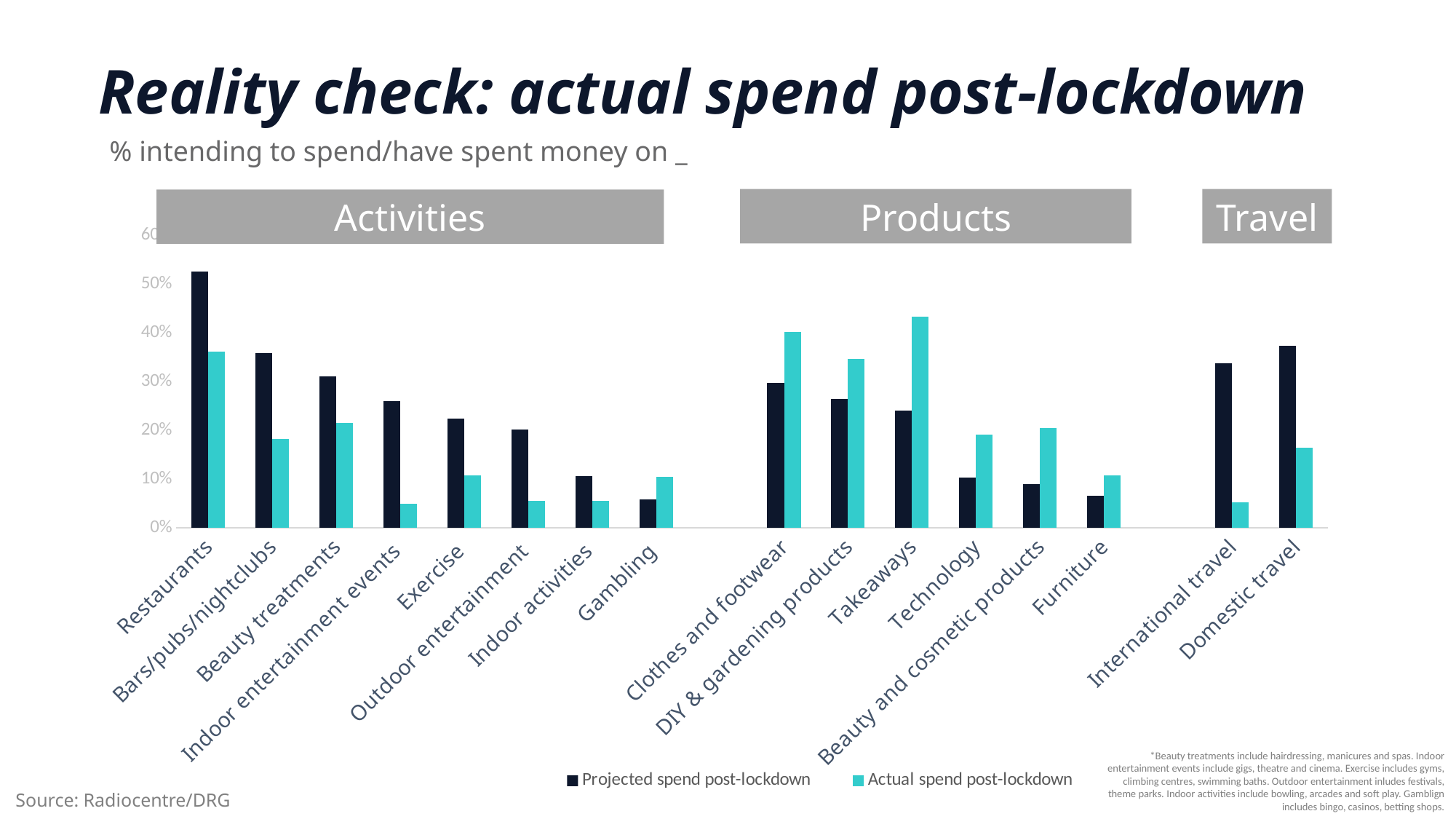
What are the three group headings shown above the chart? Activities, Products, Travel Is the Actual spend post-lockdown value for International travel greater or less than 10%? less For Restaurants, which is larger: Projected spend post-lockdown or Actual spend post-lockdown? Projected spend post-lockdown Is the Projected spend post-lockdown value for Domestic travel greater or less than 30%? greater Which category has the highest value for Projected spend post-lockdown? Restaurants Is the Projected spend post-lockdown value for Restaurants greater or less than 40%? greater What kind of chart is shown on the slide? bar chart How many series does the legend list? 2 How many categories are plotted along the x axis? 16 For Clothes and footwear, which is larger: Projected spend post-lockdown or Actual spend post-lockdown? Actual spend post-lockdown Which category has the highest value for Actual spend post-lockdown? Takeaways